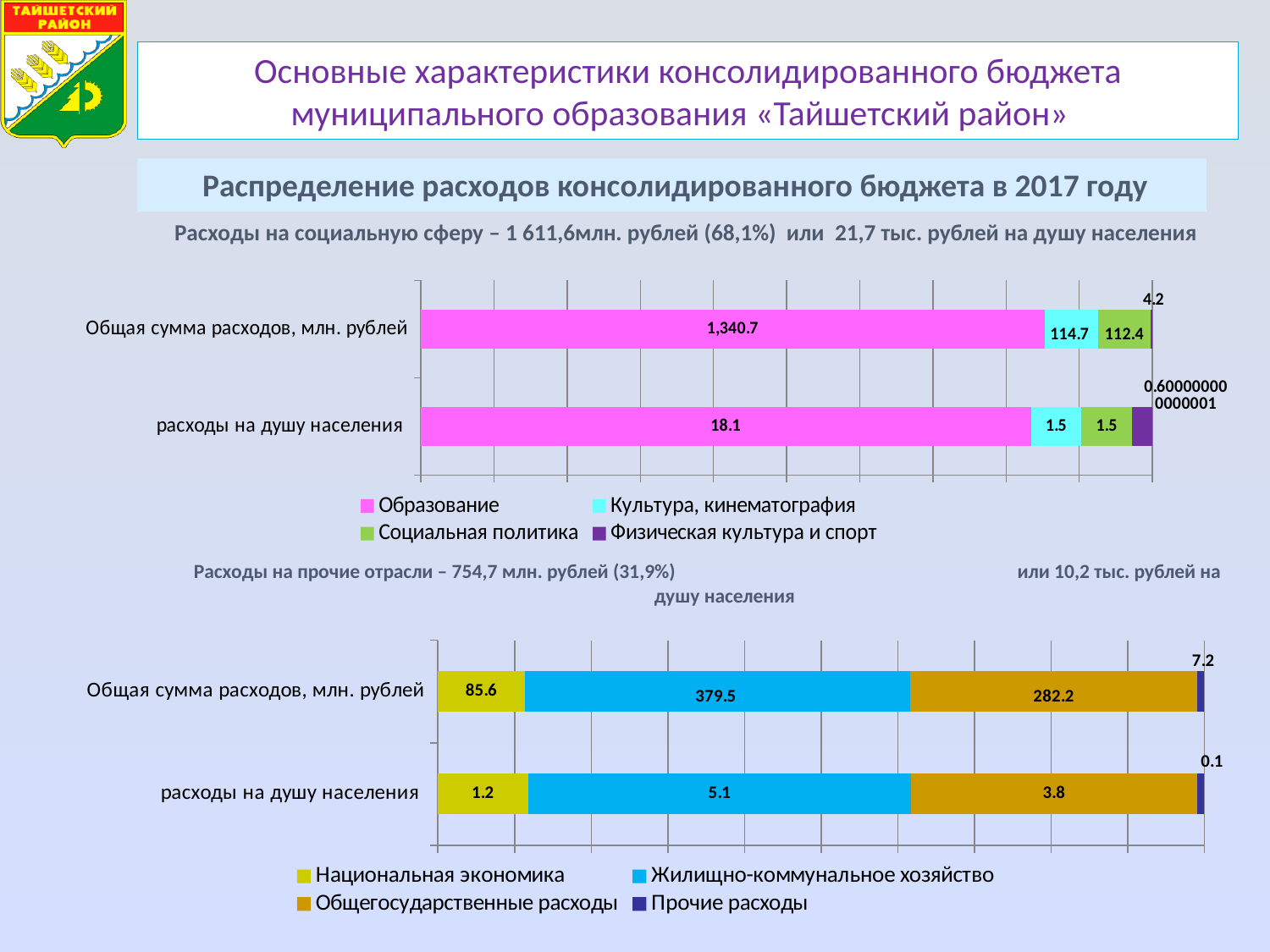
What kind of chart is the bottom chart (other sectors expenses)? Stacked bar chart In the bottom chart (other sectors expenses), what is the difference between Жилищно-коммунальное хозяйство and Общегосударственные расходы in the 'Общая сумма расходов, млн. рублей' bar? 97.3 In the top chart (social sphere expenses), what is the value for Образование in the 'Общая сумма расходов, млн. рублей' bar? 1,340.7 In the top chart (social sphere expenses), what is the value for Культура, кинематография in the 'Общая сумма расходов, млн. рублей' bar? 114.7 In the bottom chart (other sectors expenses), what is the value for Жилищно-коммунальное хозяйство in the 'Общая сумма расходов, млн. рублей' bar? 379.5 How many series does the legend of the top chart (social sphere expenses) list? 4 In the top chart (social sphere expenses), what is the value for Образование in the 'расходы на душу населения' bar? 18.1 In the bottom chart (other sectors expenses), what is the total of the 'расходы на душу населения' stacked bar? 10.2 In the bottom chart (other sectors expenses), what is the value for Общегосударственные расходы in the 'расходы на душу населения' bar? 3.8 In the top chart (social sphere expenses), which series has the smallest value in the 'Общая сумма расходов, млн. рублей' bar? Физическая культура и спорт In the bottom chart (other sectors expenses), which is larger in the 'Общая сумма расходов, млн. рублей' bar: Национальная экономика or Общегосударственные расходы? Общегосударственные расходы In the bottom chart (other sectors expenses), which series has the largest value in the 'Общая сумма расходов, млн. рублей' bar? Жилищно-коммунальное хозяйство